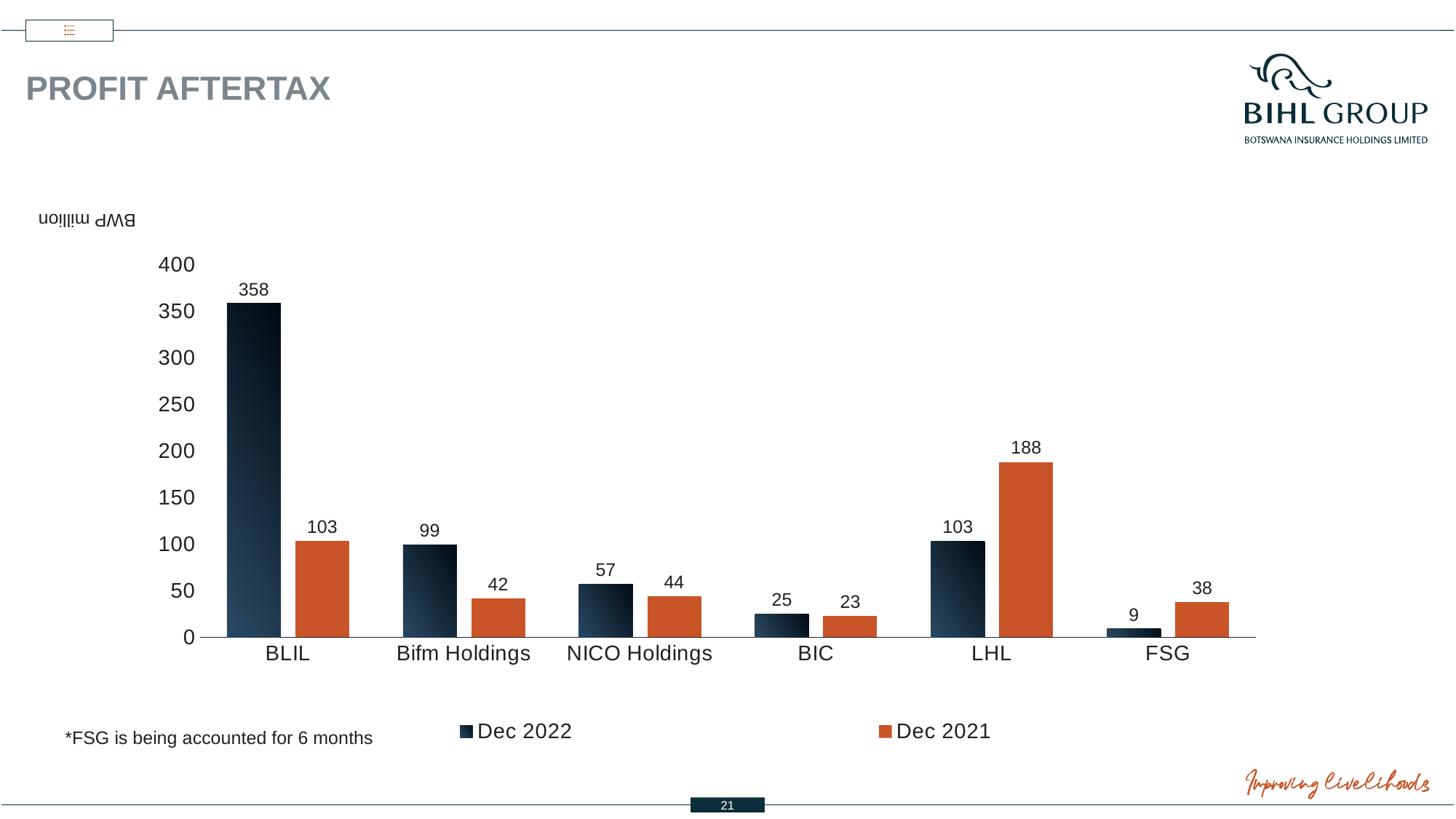
What is the Dec 2021 profit after tax for LHL? 188 How many series does the legend list? 2 Which category has the lowest Dec 2021 value? BIC What kind of chart is shown on the slide? bar chart Which category has the highest Dec 2022 value? BLIL What is the difference between the Dec 2022 and Dec 2021 values for BLIL? 255 How many categories are shown on the x axis? 6 For LHL, which is larger: the Dec 2022 value or the Dec 2021 value? Dec 2021 What is the Dec 2022 profit after tax for BLIL? 358 What is the Dec 2022 value for FSG? 9 What unit is shown on the vertical axis label? BWP million Is the Dec 2022 value for Bifm Holdings greater or less than 150? less